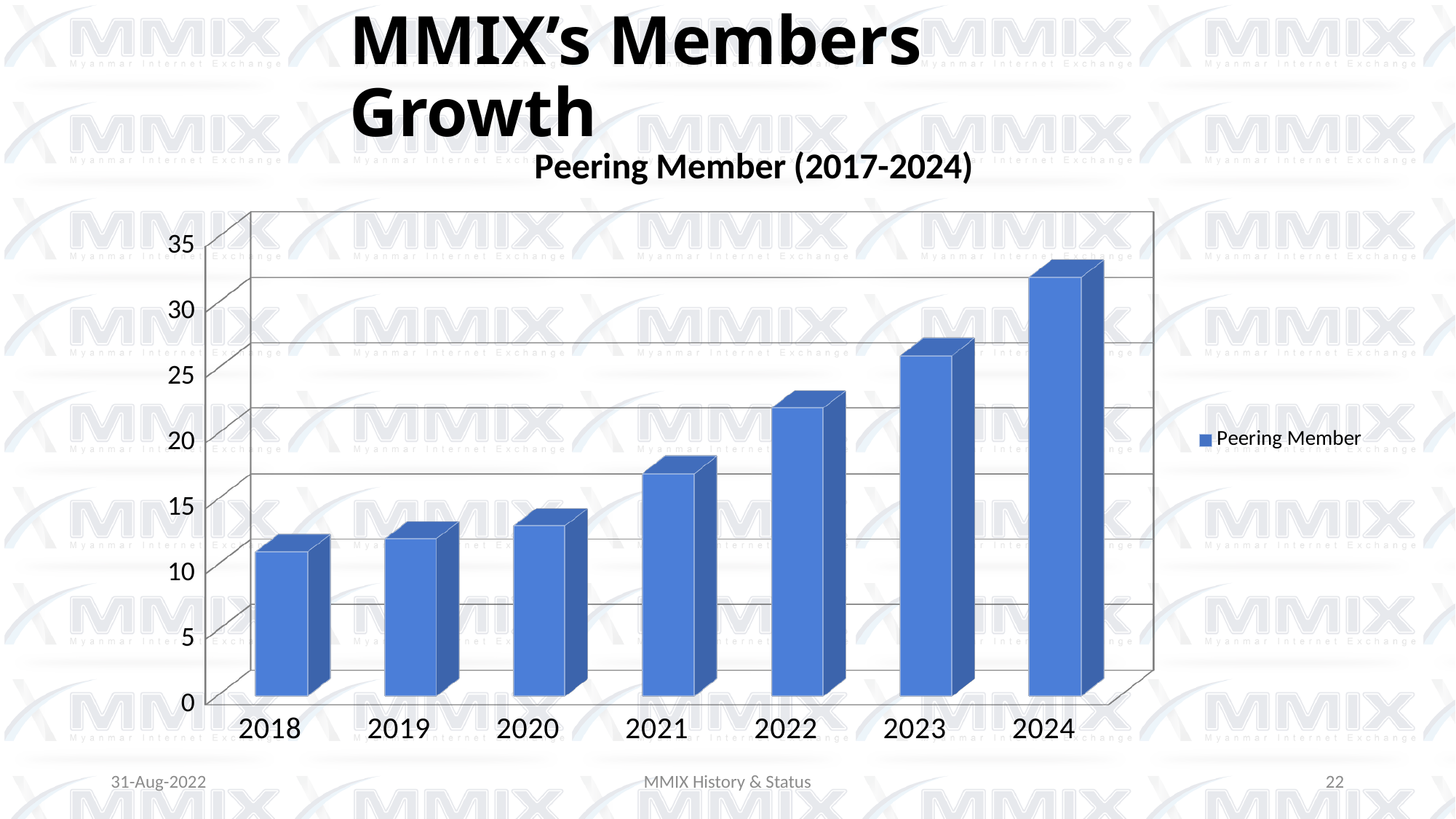
What is the title of the chart? Peering Member (2017-2024) Is the value for 2020 greater or less than 15? less Which year has the highest number of peering members? 2024 Is the value for 2024 greater or less than 30? greater Which year has the lowest number of peering members? 2018 What type of chart is shown on the slide? bar chart How many years are shown on the x axis of the chart? 7 Do the peering member values rise or fall from 2018 to 2024? rise Is the value for 2021 greater or less than 20? less What is the name of the series shown in the legend? Peering Member How many series does the chart legend list? 1 Which year has more peering members, 2022 or 2019? 2022